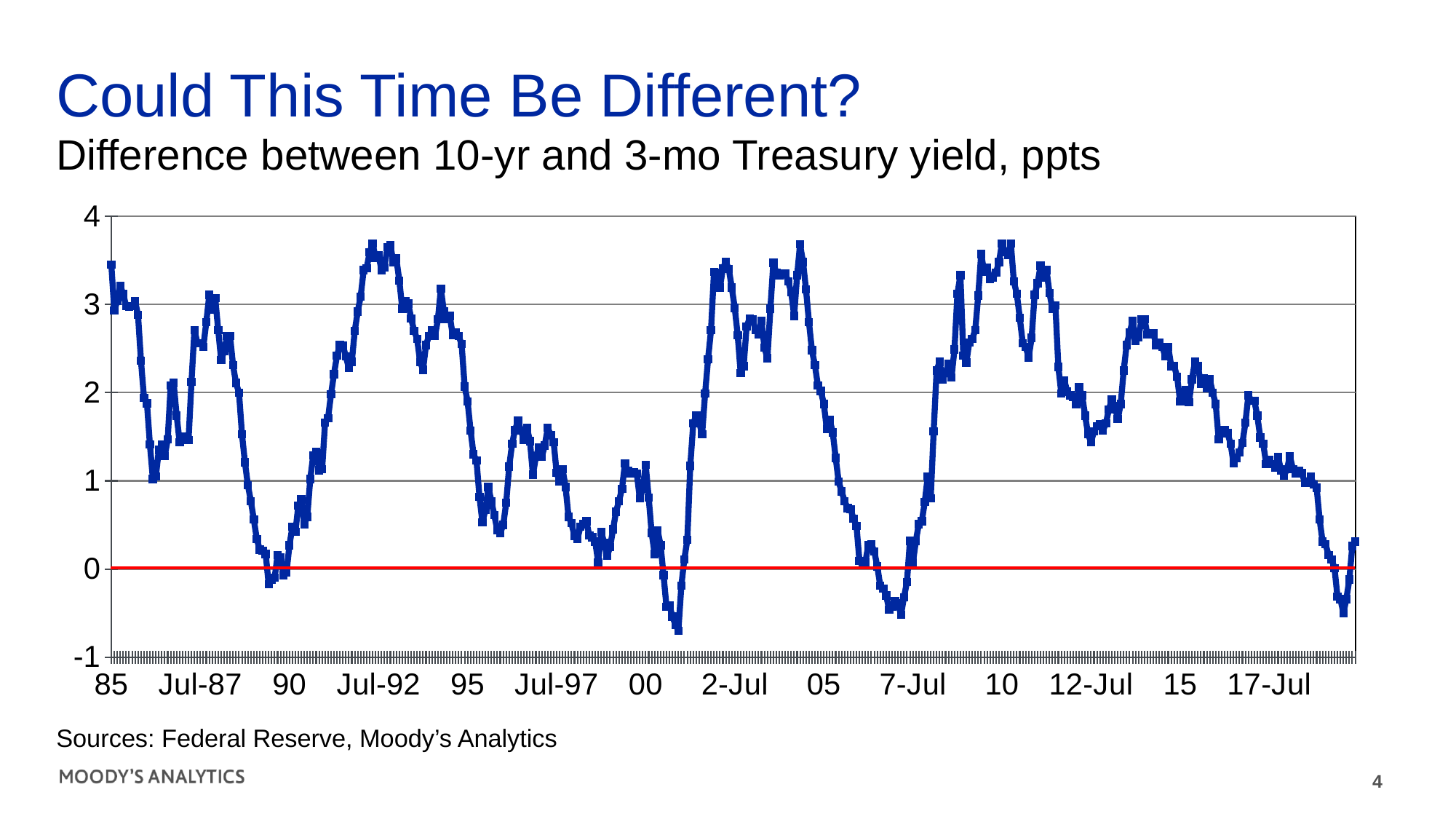
Is the value at 90 greater or less than 1? less Is the value at 10 greater or less than 3? greater Between 90 and Jul-92, does the line generally rise or fall? rise Is the value at Jul-92 greater or less than 3? greater Between 10 and 17-Jul, does the line generally rise or fall? fall What quantity does the chart plot, according to the subtitle? Difference between 10-yr and 3-mo Treasury yield, ppts How many labels are shown on the x axis? 14 What kind of chart is shown on the slide? line chart What is the title of the slide? Could This Time Be Different?